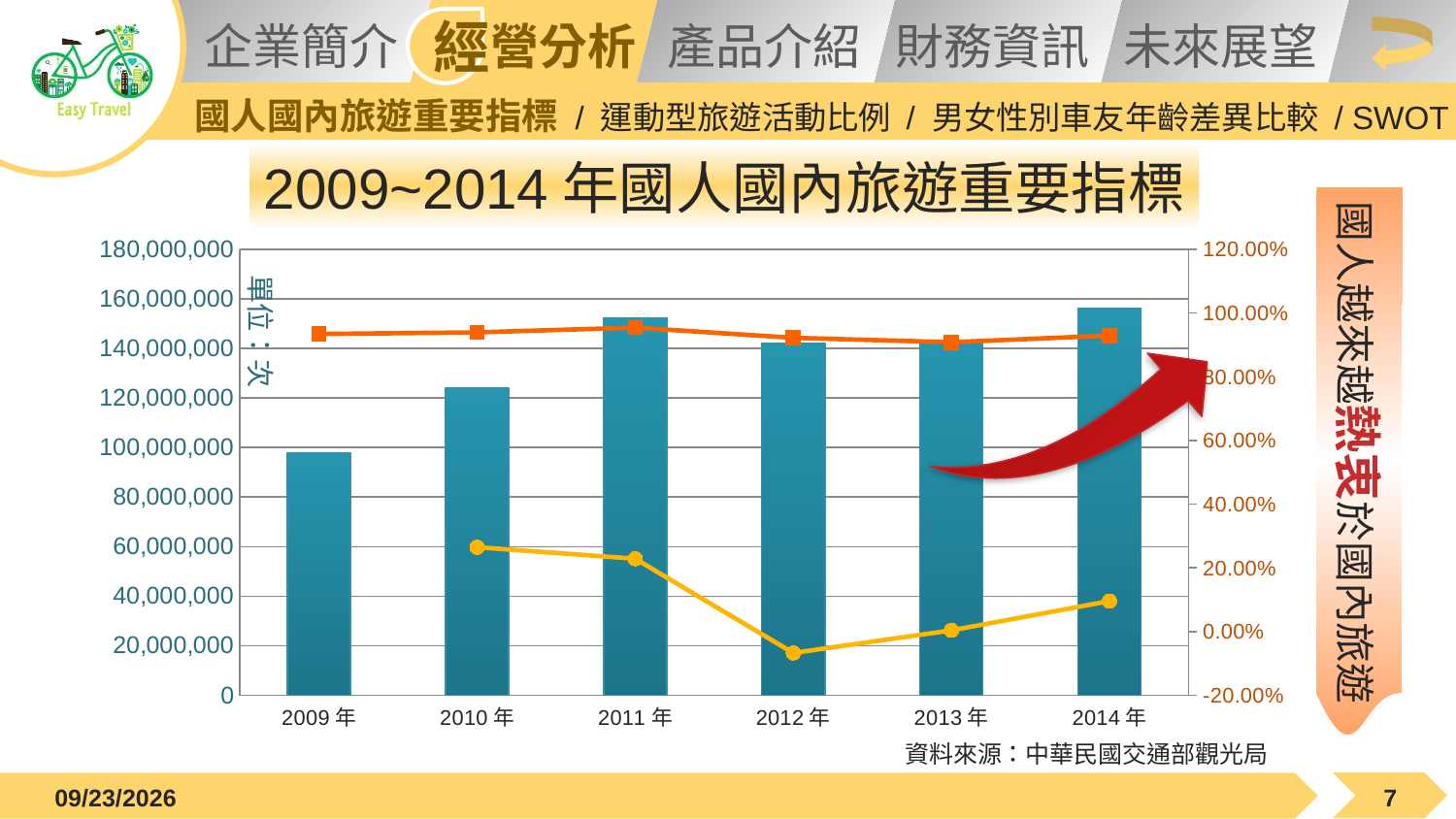
What is the title of the chart? 2009~2014 年國人國內旅遊重要指標 Is the bar value for 2010 年 greater or less than 100,000,000? greater Is the bar value for 2011 年 greater or less than 140,000,000? greater How many years are shown on the x axis of the chart? 6 Which bar is taller, 2011 年 or 2012 年? 2011 年 Is the yellow line's value for 2012 年 greater or less than 0.00%? less What kind of chart is shown on the slide? A combined bar and line chart Which year has the lowest bar in the chart? 2009 年 Do the bars rise or fall from 2009 年 to 2011 年? rise In which year does the yellow line reach its lowest point? 2012 年